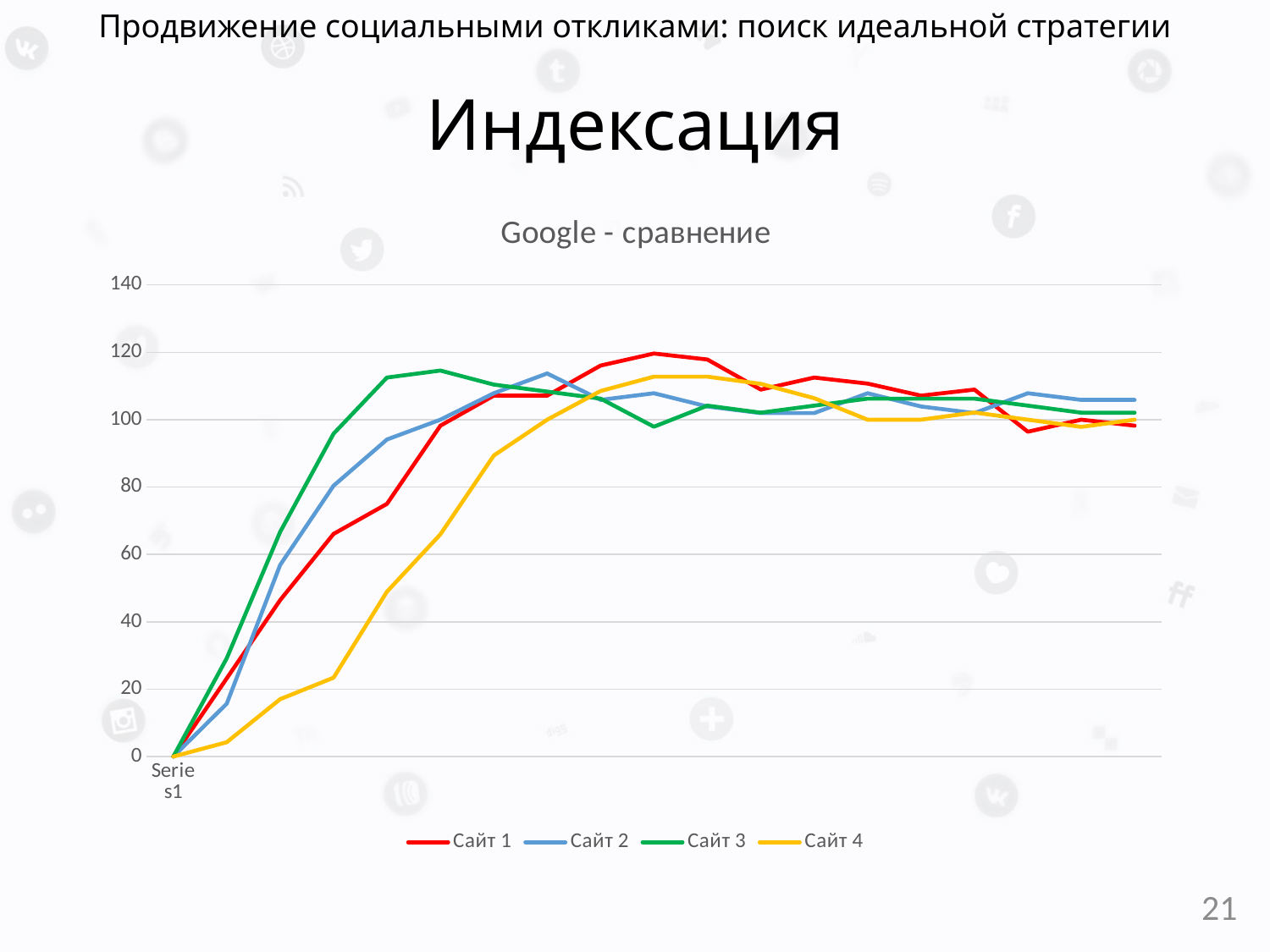
What kind of chart is shown under the title "Google - сравнение"? line chart Which series rises fastest at the start of the "Google - сравнение" chart? Сайт 3 Is the peak value of Сайт 4 in the "Google - сравнение" chart greater or less than 120? less Do the values of Сайт 3 rise or fall over the first part of the x axis in the "Google - сравнение" chart? rise Is the final value of Сайт 2 at the right end of the "Google - сравнение" chart greater or less than 80? greater At what value do all four series start at the left of the "Google - сравнение" chart? 0 How many series does the legend of the "Google - сравнение" chart list? 4 What are the series names listed in the legend of the "Google - сравнение" chart? Сайт 1, Сайт 2, Сайт 3, Сайт 4 Is the peak value of Сайт 1 in the "Google - сравнение" chart greater or less than 100? greater What colour is the line for Сайт 1 in the "Google - сравнение" chart? red What is the highest value shown on the vertical axis of the "Google - сравнение" chart? 140 Which series is slowest to rise at the start of the "Google - сравнение" chart? Сайт 4